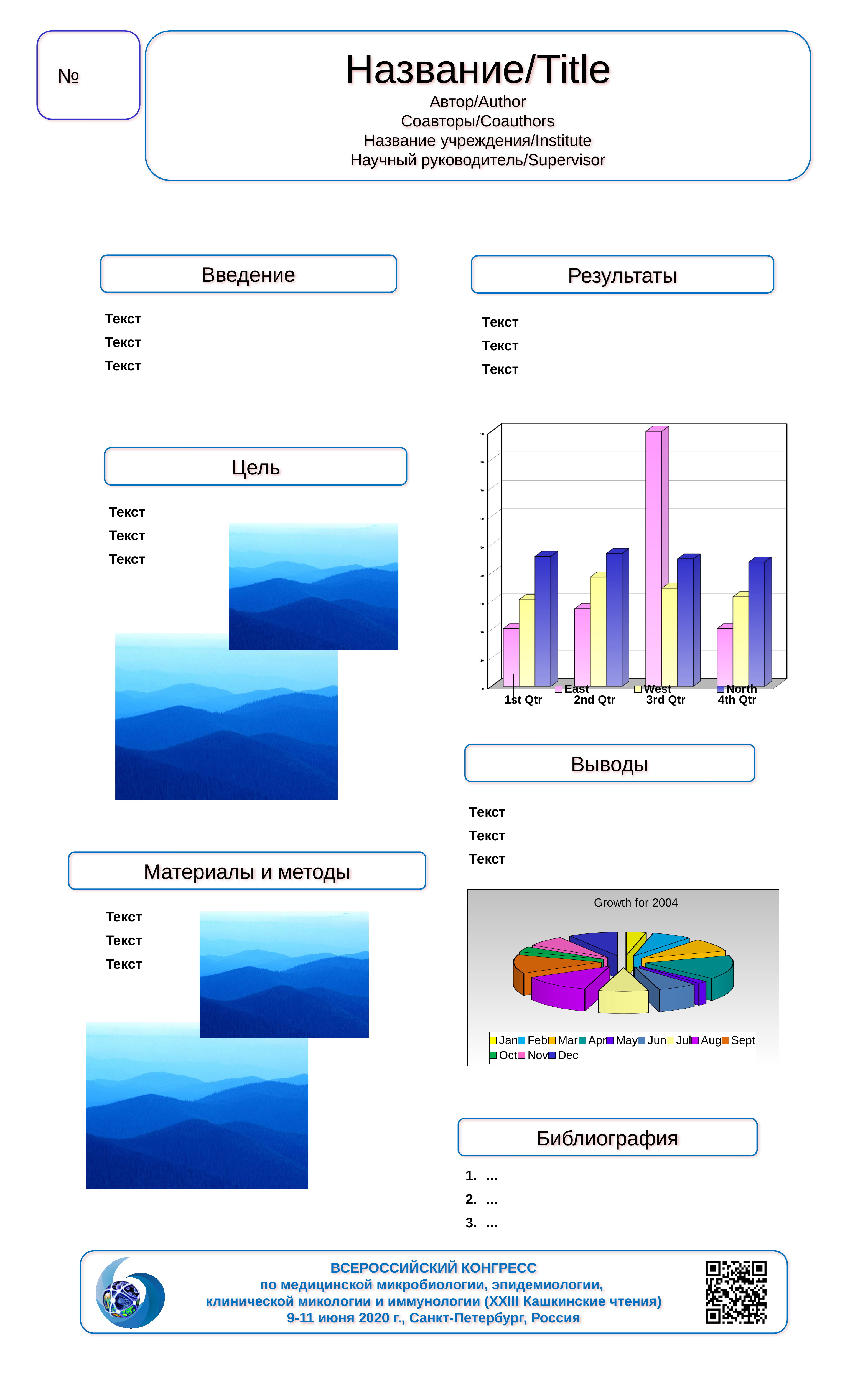
In the bar chart with quarters on the x axis, which quarter has the highest East value? 3rd Qtr What kind of chart is the chart titled Growth for 2004? pie chart In the bar chart with quarters on the x axis, is the North value for 1st Qtr greater or less than 40? greater In the bar chart with quarters on the x axis, which series is shown in pink? East In the chart titled Growth for 2004, how many entries does the legend list? 12 In the bar chart with quarters on the x axis, how many categories are shown on the x axis? 4 In the bar chart with quarters on the x axis, is the East value for 1st Qtr greater or less than 30? less In the bar chart with quarters on the x axis, which is larger for 2nd Qtr: the East value or the North value? North What is the title of the pie chart in the Выводы section? Growth for 2004 What kind of chart is the chart in the Результаты section (the one with 1st Qtr to 4th Qtr on the x axis)? bar chart In the bar chart with quarters on the x axis, how many series does the legend list? 3 In the bar chart with quarters on the x axis, is the East value for 3rd Qtr greater or less than 80? greater